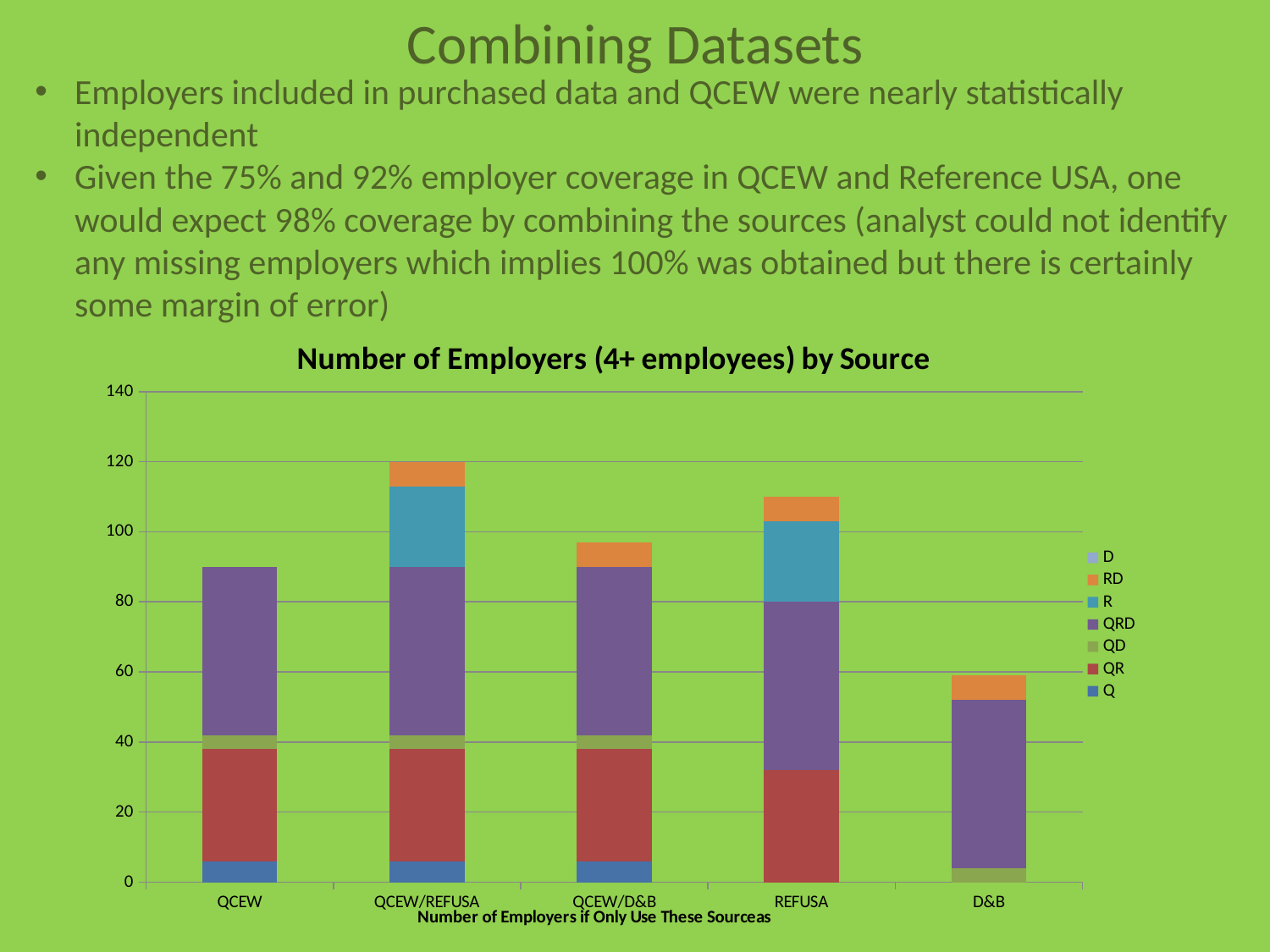
How many source categories are shown along the x axis of the chart? 5 How many series does the chart's legend list? 7 Which source category has the tallest stacked bar? QCEW/REFUSA Which has a taller total bar, QCEW/D&B or D&B? QCEW/D&B Is the total bar height for REFUSA greater or less than 100? greater Is the total bar height for D&B greater or less than 80? less Which source category has the shortest stacked bar? D&B What is the title of the chart? Number of Employers (4+ employees) by Source What kind of chart is shown on the slide? Stacked bar chart Which legend entry is shown in purple? QRD Is the total bar height for QCEW greater or less than 100? less Which has a taller total bar, QCEW or REFUSA? REFUSA